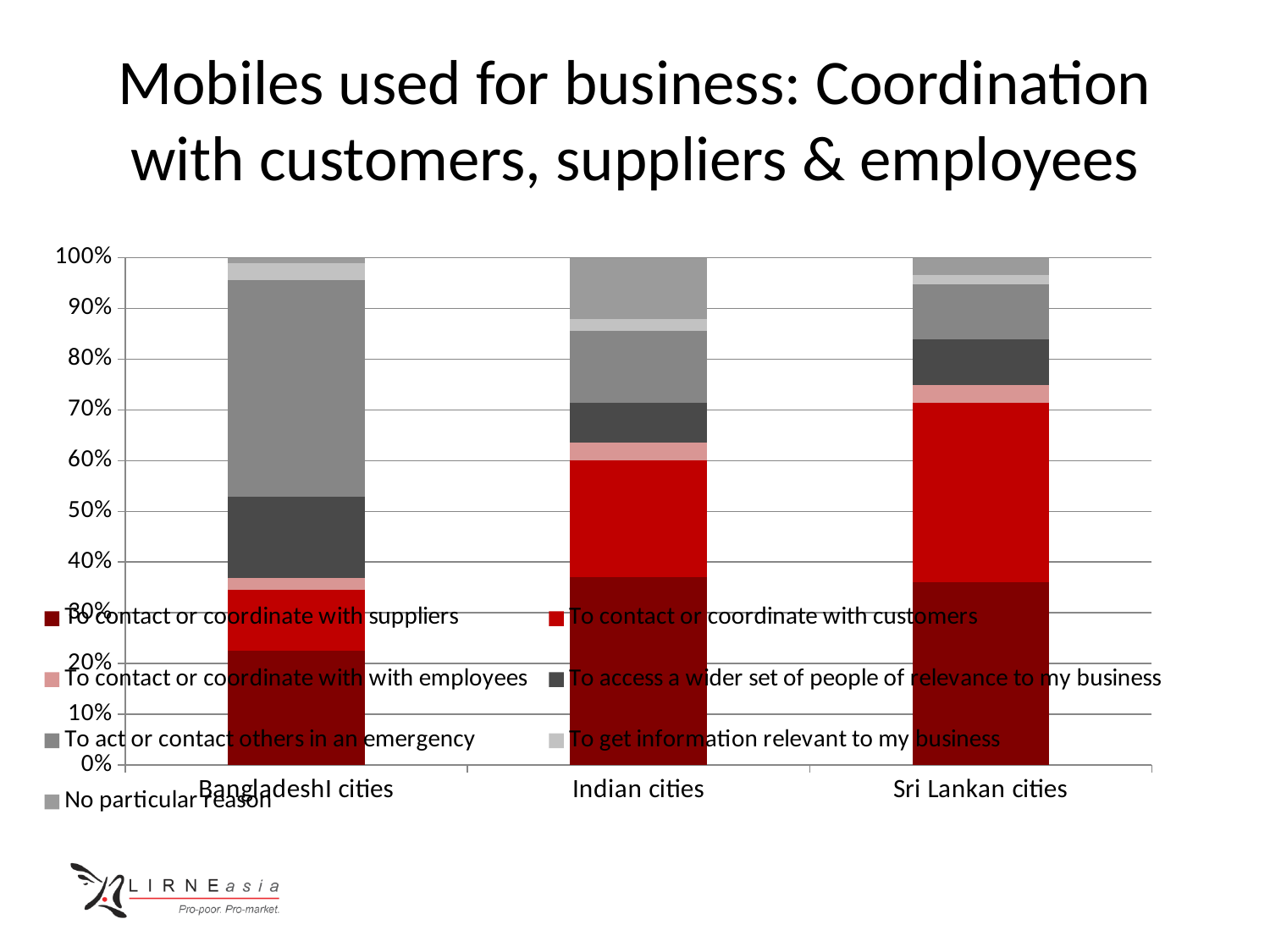
Is the 'To contact or coordinate with suppliers' segment for Indian cities greater or less than 30%? greater What kind of chart is shown on the slide? Stacked bar chart What is the total height of each stacked bar on the percentage axis? 100% What is the title of the chart on the slide? Mobiles used for business: Coordination with customers, suppliers & employees Which city category has the largest 'To act or contact others in an emergency' segment? Bangladeshi cities How many city categories are shown on the x axis? 3 How many series does the legend list? 7 Is the 'To contact or coordinate with suppliers' segment for Bangladeshi cities greater or less than 30%? less Which city category has the smallest 'To contact or coordinate with suppliers' segment? Bangladeshi cities Is the 'To contact or coordinate with customers' segment for Sri Lankan cities greater or less than 20%? greater Which has a larger 'To contact or coordinate with customers' segment, Bangladeshi cities or Sri Lankan cities? Sri Lankan cities